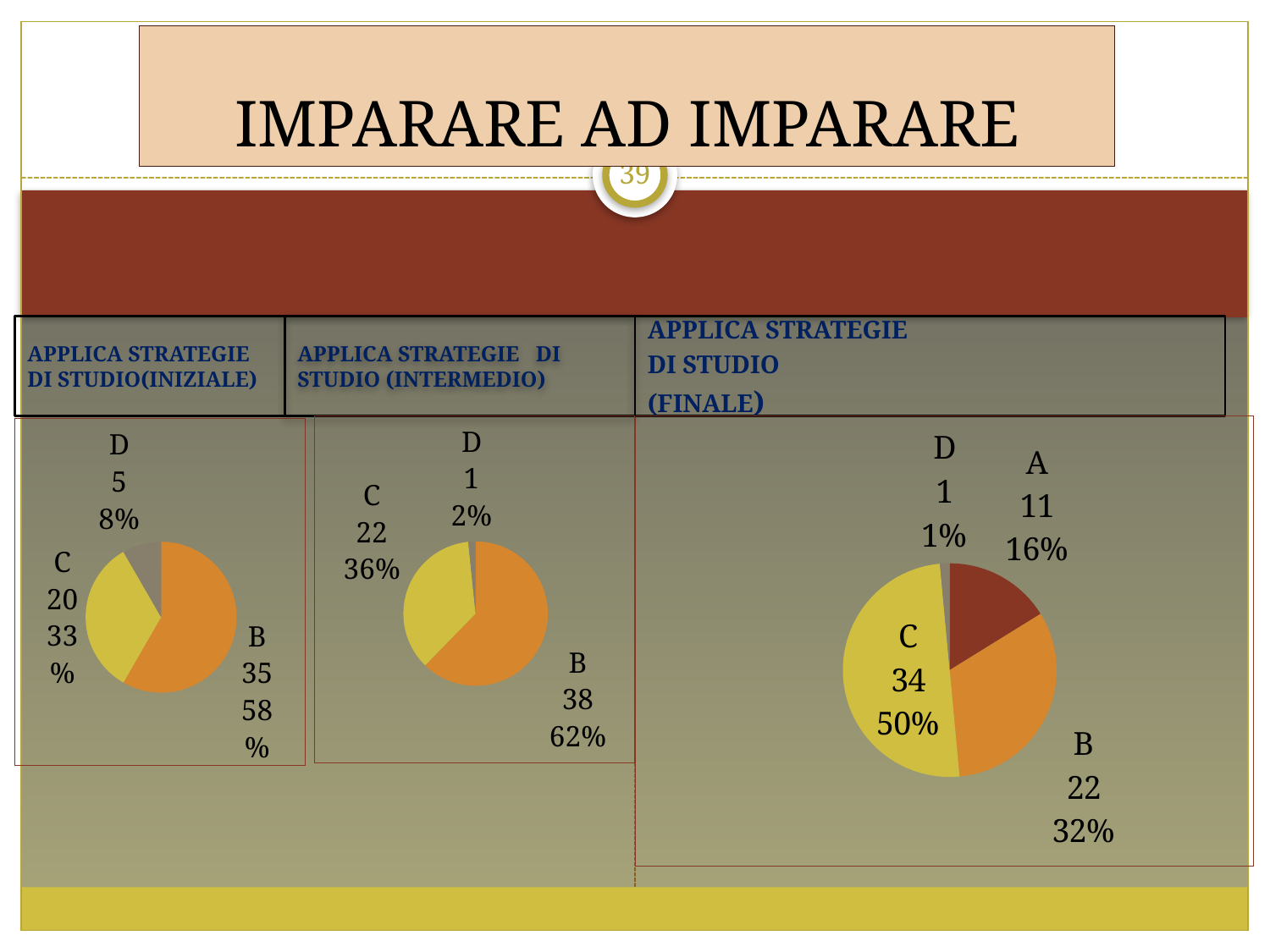
In the APPLICA STRATEGIE DI STUDIO (INTERMEDIO) chart, what is the value for C? 22 In the APPLICA STRATEGIE DI STUDIO (FINALE) chart, what is the value for A? 11 In the APPLICA STRATEGIE DI STUDIO (INIZIALE) chart, what percentage share does C have? 33% In the APPLICA STRATEGIE DI STUDIO (FINALE) chart, which is larger, the value for A or the value for B? B In the APPLICA STRATEGIE DI STUDIO (INTERMEDIO) chart, what percentage share does B have? 62% In the APPLICA STRATEGIE DI STUDIO (INIZIALE) chart, which category has the smallest slice? D How many categories are shown in the APPLICA STRATEGIE DI STUDIO (FINALE) chart? 4 What type of chart is used for APPLICA STRATEGIE DI STUDIO (INIZIALE)? Pie chart In the APPLICA STRATEGIE DI STUDIO (INTERMEDIO) chart, what is the difference between the values for B and C? 16 In the APPLICA STRATEGIE DI STUDIO (FINALE) chart, which category has the largest slice? C In the APPLICA STRATEGIE DI STUDIO (INIZIALE) chart, what is the value for B? 35 In the APPLICA STRATEGIE DI STUDIO (FINALE) chart, what percentage share does B have? 32%